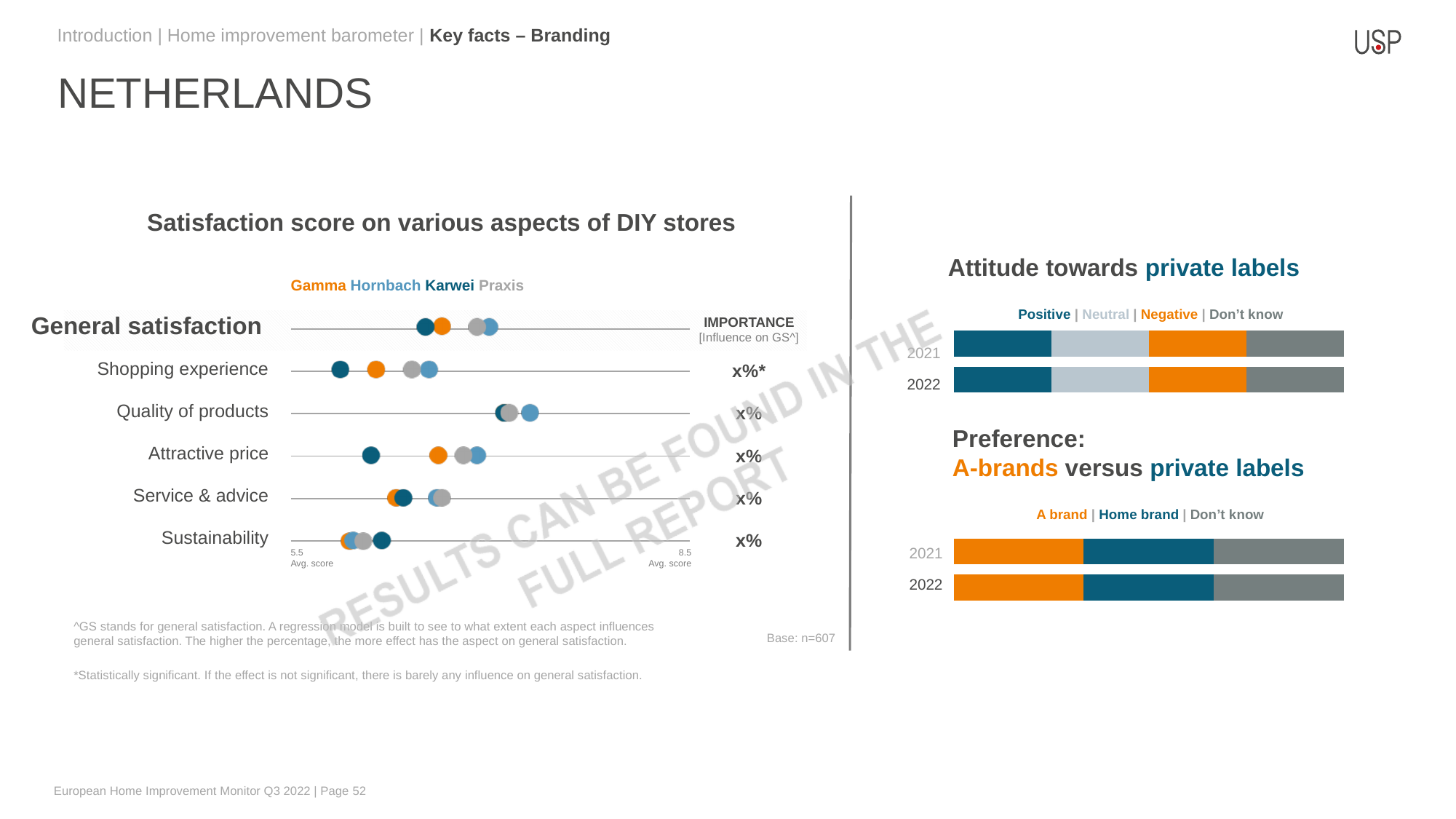
In the 'Satisfaction score on various aspects of DIY stores' chart, which store has the higher score for Attractive price, Karwei or Hornbach? Hornbach In the 'Satisfaction score on various aspects of DIY stores' chart, which colour represents Gamma? Orange In the 'Satisfaction score on various aspects of DIY stores' chart, which store has the higher score for Shopping experience, Karwei or Hornbach? Hornbach What kind of chart is the 'Satisfaction score on various aspects of DIY stores' chart? Dot plot How many categories does the legend of the 'Attitude towards private labels' chart list? 4 What kind of chart is the 'Attitude towards private labels' chart? Stacked bar chart How many years are shown in the 'Preference: A-brands versus private labels' chart? 2 In the 'Satisfaction score on various aspects of DIY stores' chart, which store has the higher score for Sustainability, Gamma or Karwei? Karwei In the 'Satisfaction score on various aspects of DIY stores' chart, which store has the lowest score for Shopping experience? Karwei How many options does the legend of the 'Preference: A-brands versus private labels' chart list? 3 How many stores does the legend of the 'Satisfaction score on various aspects of DIY stores' chart list? 4 How many aspects are listed in the 'Satisfaction score on various aspects of DIY stores' chart? 6